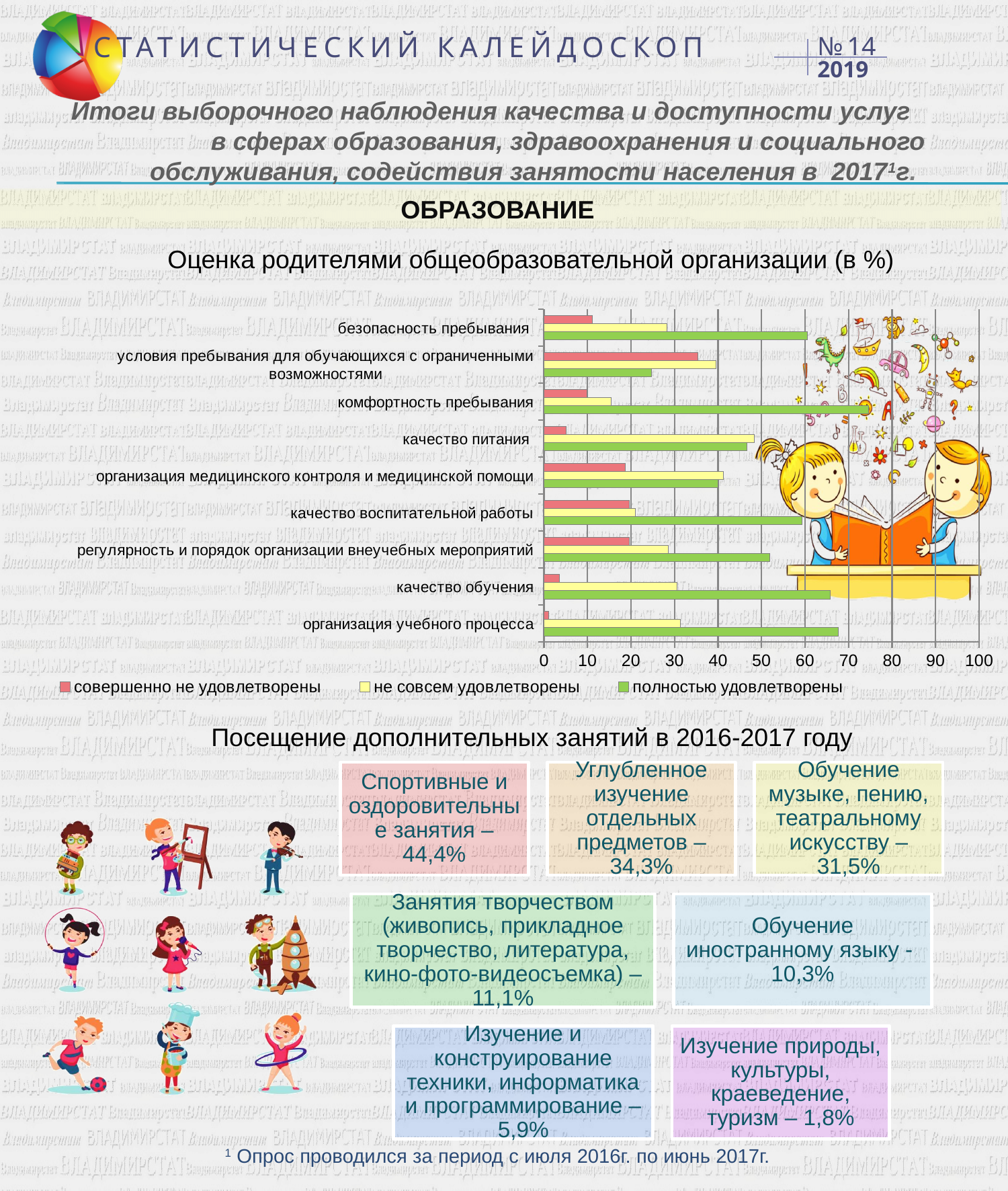
Is the value for 'полностью удовлетворены' in 'комфортность пребывания' greater or less than 60? greater What kind of chart is used for 'Оценка родителями общеобразовательной организации (в %)'? bar chart Is the value for 'полностью удовлетворены' in 'условия пребывания для обучающихся с ограниченными возможностями' greater or less than 30? less How many series does the legend of the chart list? 3 For 'безопасность пребывания', which is larger: 'не совсем удовлетворены' or 'полностью удовлетворены'? полностью удовлетворены Is the value for 'совершенно не удовлетворены' in 'организация учебного процесса' greater or less than 10? less Which category has the highest value for 'совершенно не удовлетворены'? условия пребывания для обучающихся с ограниченными возможностями Which category has the lowest value for 'совершенно не удовлетворены'? организация учебного процесса Which category has the highest value for 'полностью удовлетворены'? комфортность пребывания How many categories are shown on the chart's vertical axis? 9 What colour represents 'полностью удовлетворены' in the chart legend? green